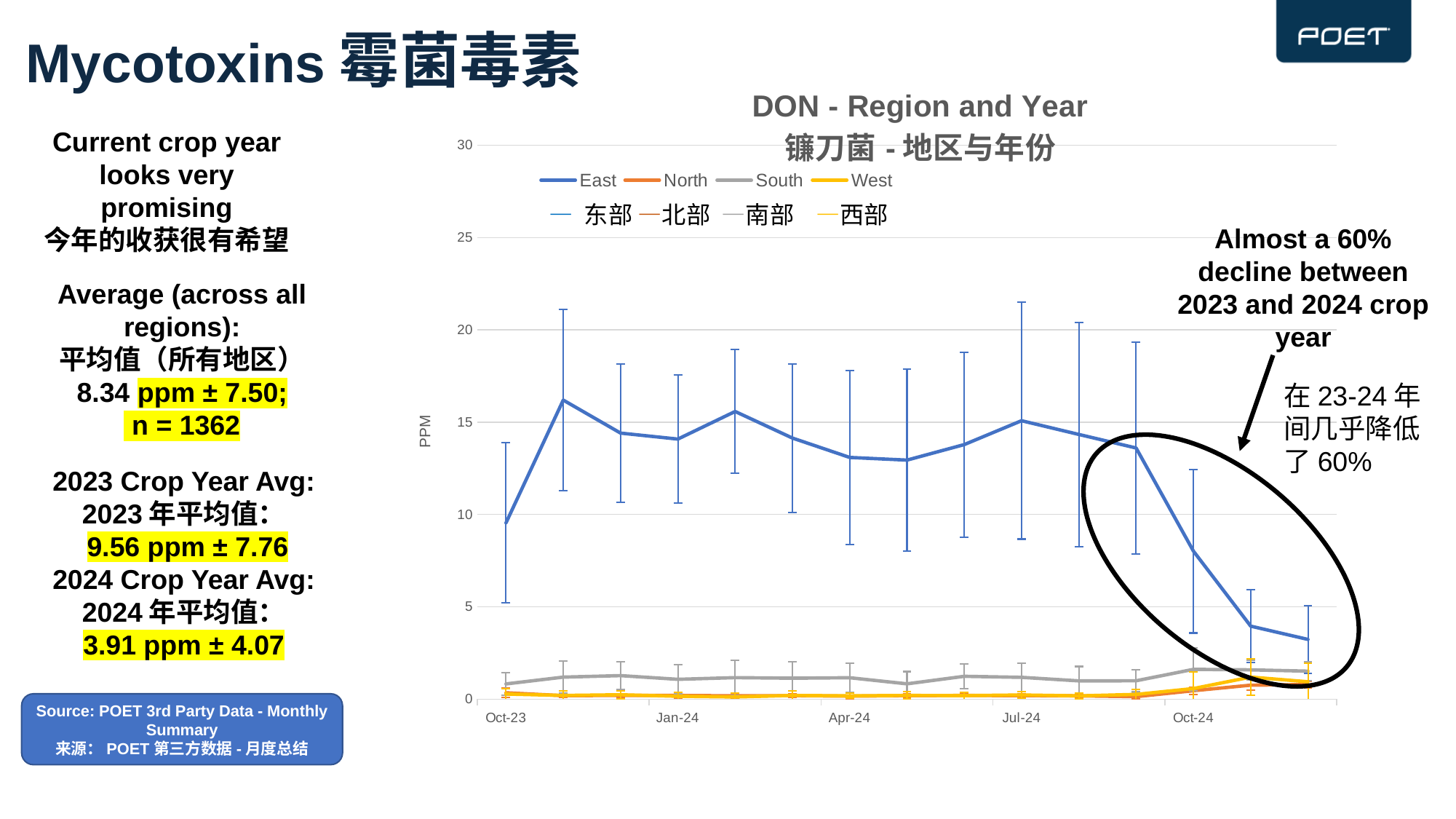
How many series does the chart legend list? 4 Which is larger at Jan-24, the value for East or the value for South? East How many month labels are shown on the x axis? 5 What kind of chart is shown on the slide? line chart Is the value for East at Oct-24 greater or less than 10? less What are the series names listed in the chart legend (in English)? East, North, South, West Is the value for East at Jan-24 greater or less than 10? greater Does the East series rise or fall between Jul-24 and the last point on the chart? fall Is the value for East at Oct-23 greater or less than 5? greater What is the English title of the chart? DON - Region and Year Which series has the highest values across most of the chart? East